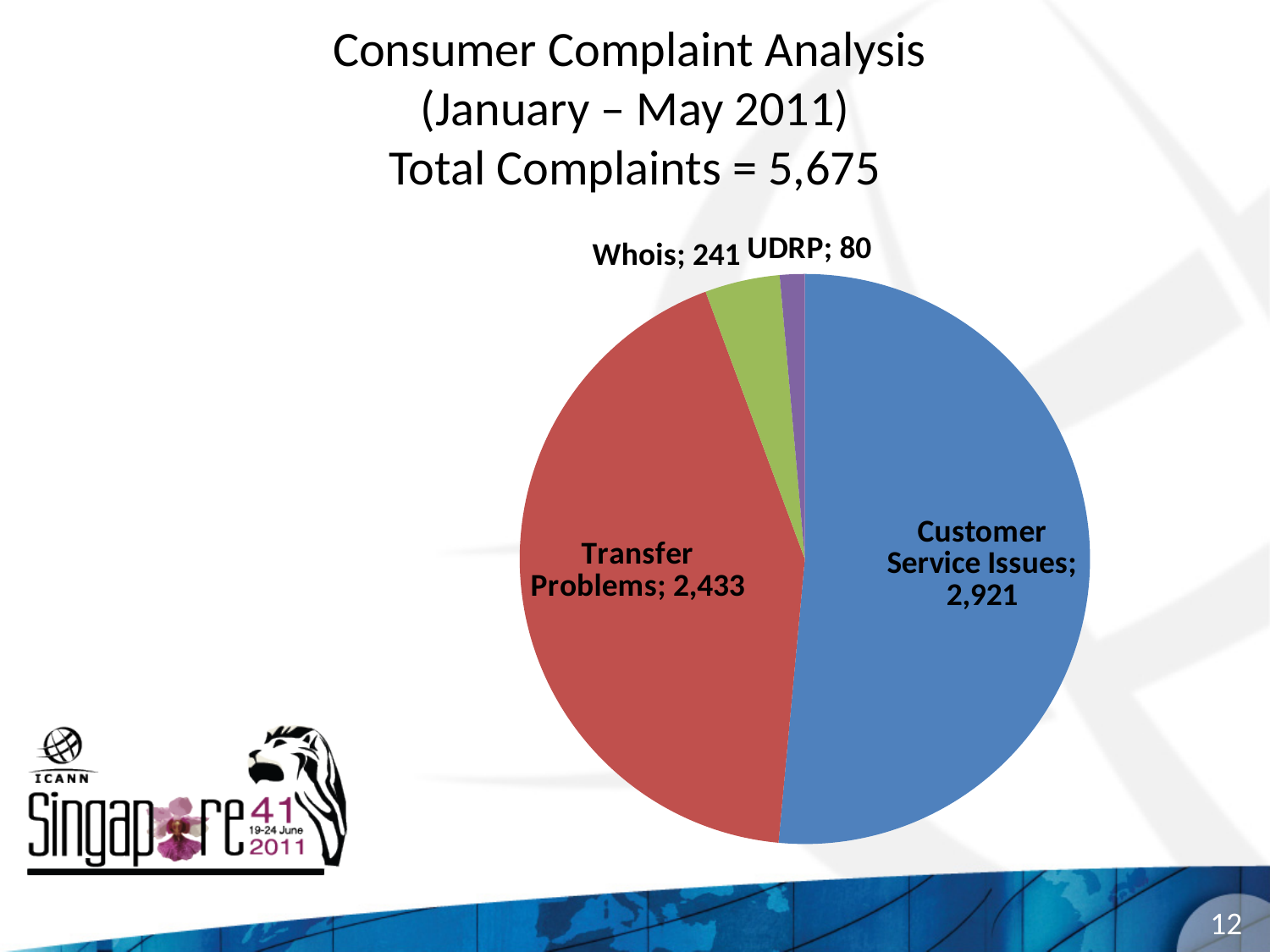
Which category has more complaints, Whois or UDRP? Whois What kind of chart is shown on the slide? pie chart How many complaints are attributed to UDRP? 80 How many complaints are attributed to Whois? 241 What is the difference between the number of Customer Service Issues complaints and Transfer Problems complaints? 488 What is the total number of complaints stated in the chart title? 5,675 How many complaints are attributed to Customer Service Issues? 2,921 Which complaint category has the smallest slice of the pie? UDRP Which complaint category has the largest slice of the pie? Customer Service Issues What is the difference between the number of Whois complaints and UDRP complaints? 161 How many complaint categories are shown in the pie chart? 4 How many complaints are attributed to Transfer Problems? 2,433